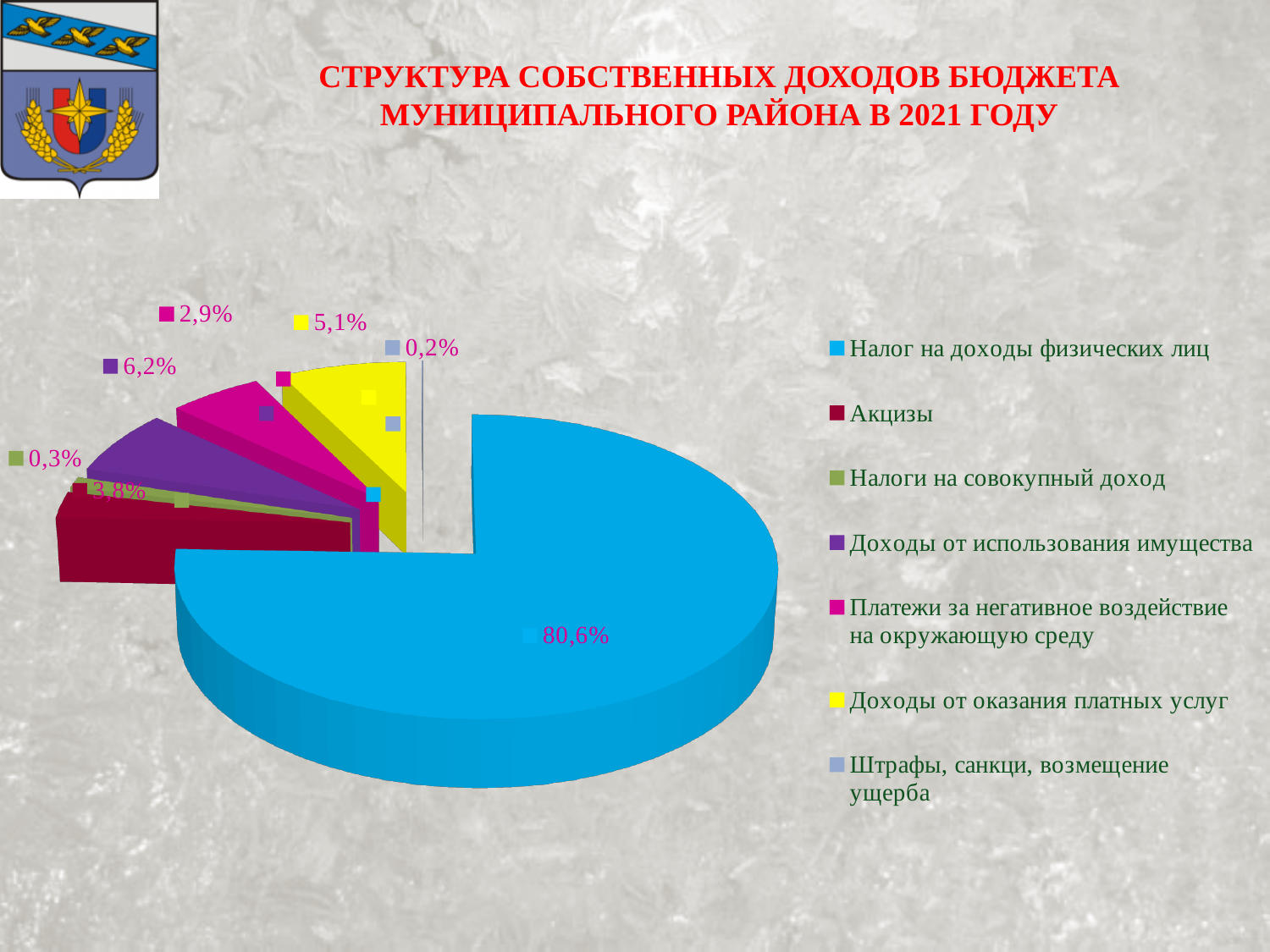
Which category has the largest slice of the pie? Налог на доходы физических лиц What type of chart is shown on the slide? Pie chart What share of the pie does Налог на доходы физических лиц account for? 80,6% Which category has the smallest slice of the pie? Штрафы, санкци, возмещение ущерба By how many percentage points does Доходы от использования имущества exceed Доходы от оказания платных услуг? 1,1 What is the value shown for Доходы от использования имущества? 6,2% What is the value shown for Доходы от оказания платных услуг? 5,1% What is the value shown for Платежи за негативное воздействие на окружающую среду? 2,9% How many categories does the legend list? 7 Which is larger: Доходы от использования имущества or Доходы от оказания платных услуг? Доходы от использования имущества What is the value shown for Штрафы, санкци, возмещение ущерба? 0,2% What is the value shown for Налоги на совокупный доход? 0,3%